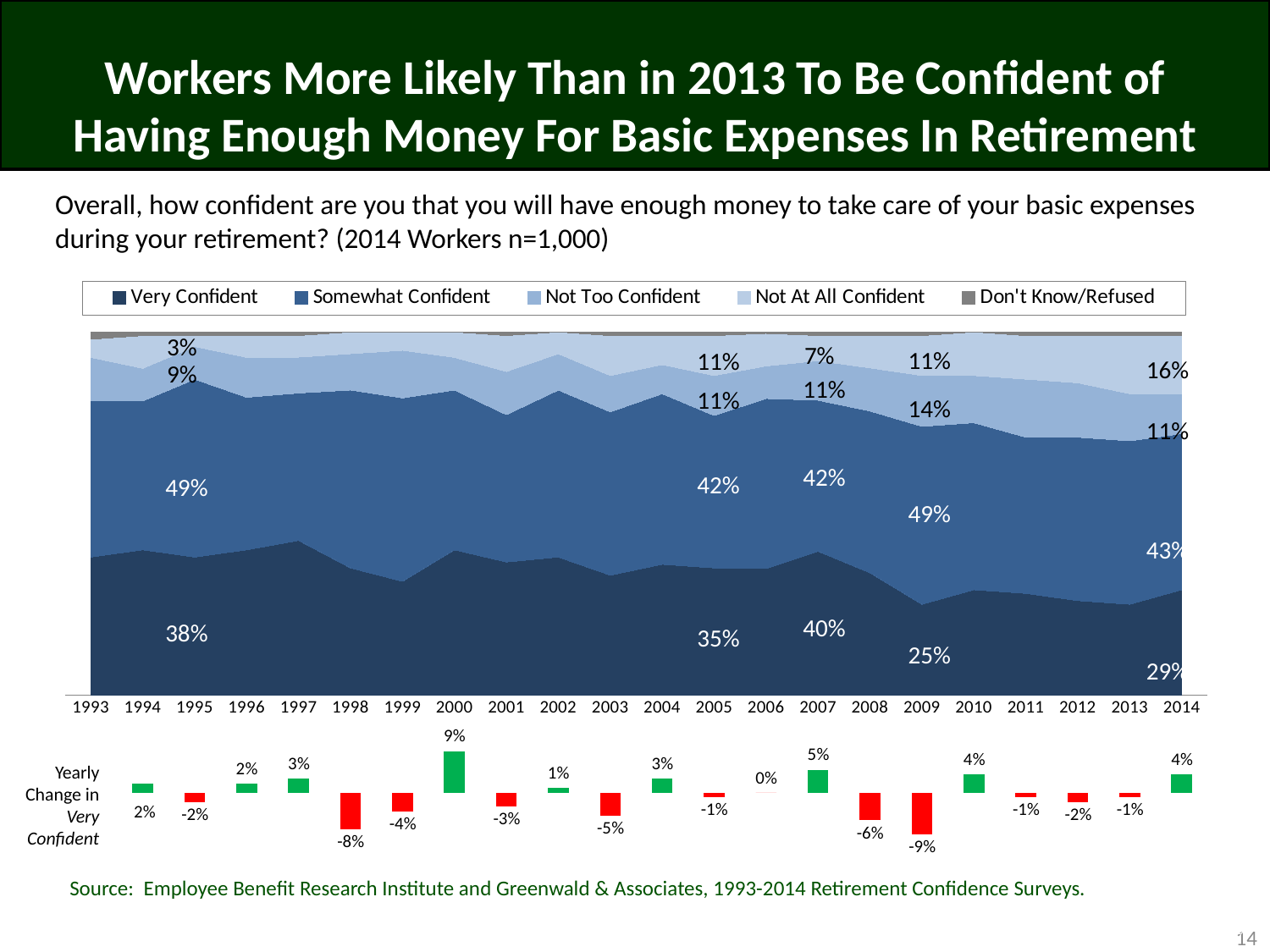
In the Yearly Change in Very Confident bar chart, what is the value for 2014? 4% In the stacked area chart, what percentage of workers were Very Confident in 2014? 29% In the Yearly Change in Very Confident bar chart, what is the value for 1998? -8% In the Yearly Change in Very Confident bar chart, which year shows the largest decrease? 2009 What kind of chart is the Yearly Change in Very Confident chart at the bottom of the slide? Bar chart In the stacked area chart, what percentage of workers were Not At All Confident in 2014? 16% In the Yearly Change in Very Confident bar chart, which year shows the largest increase? 2000 In the stacked area chart, how many series does the legend list? 5 In the stacked area chart, what percentage of workers were Very Confident in 2009? 25% In the stacked area chart, what is the difference between the Very Confident share in 2007 and in 2009? 15% In the stacked area chart, which was larger in 2014: the Somewhat Confident share or the Very Confident share? Somewhat Confident